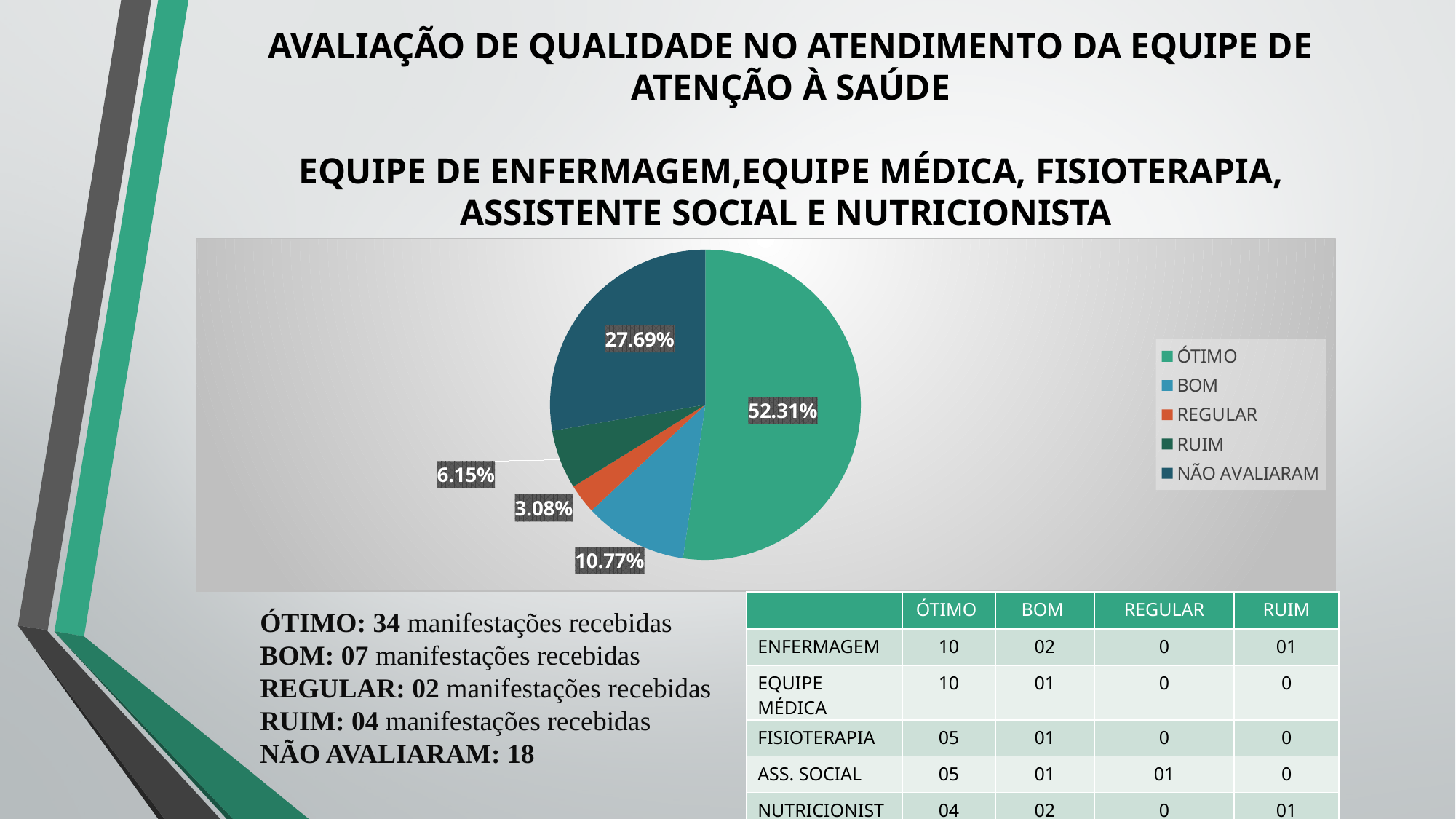
What kind of chart is shown on the slide? pie chart Which slice is larger, BOM or RUIM? BOM How many entries does the legend list? 5 What share of the pie does ÓTIMO represent? 52.31% Which category has the smallest slice of the pie? REGULAR What share of the pie does RUIM represent? 6.15% What share of the pie does BOM represent? 10.77% How many slices does the pie chart have? 5 Which category has the largest slice of the pie? ÓTIMO What is the difference in percentage points between the ÓTIMO slice and the NÃO AVALIARAM slice? 24.62